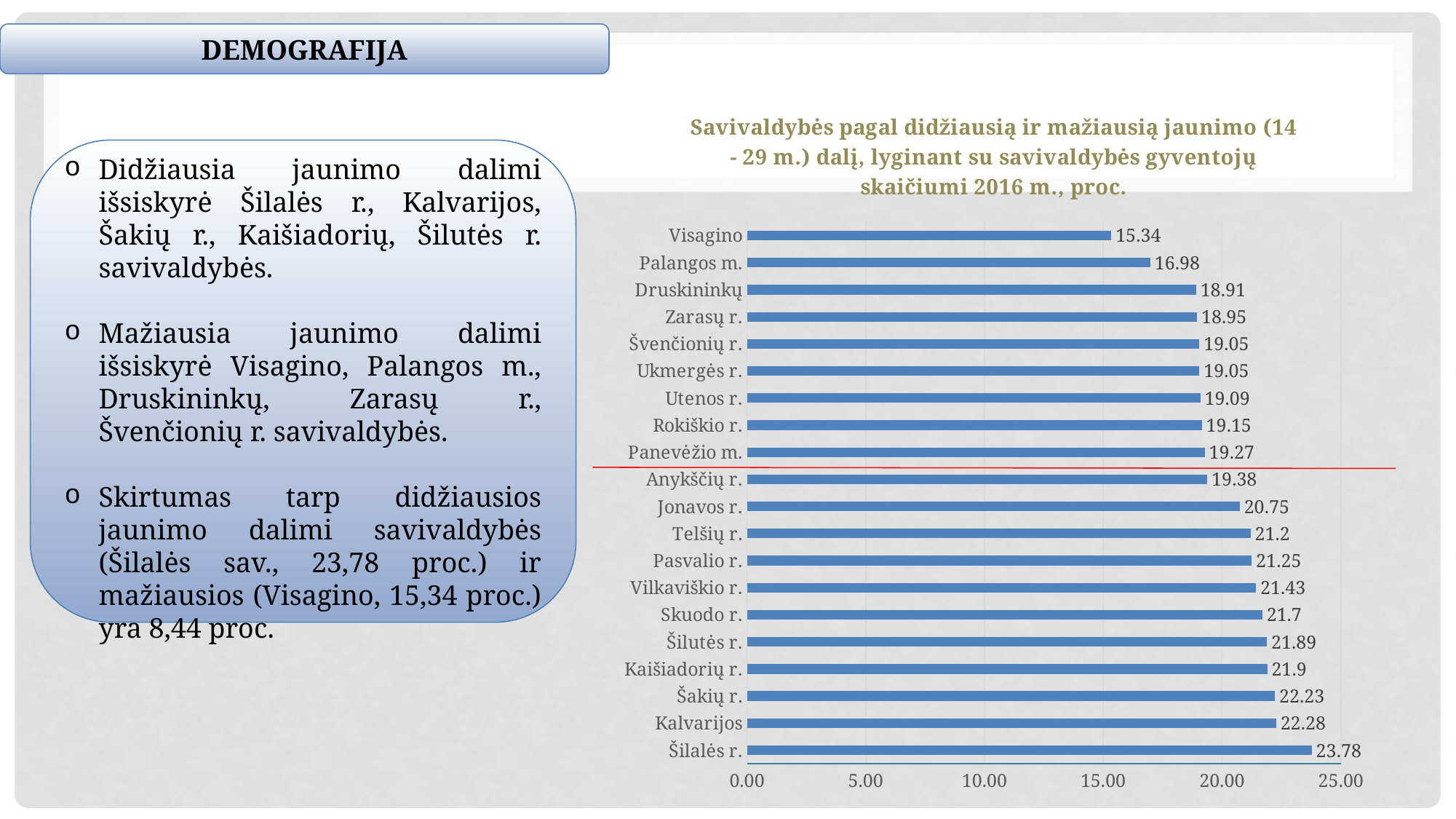
What is the value for Kalvarijos? 22.28 What is the difference between the values for Palangos m. and Druskininkų? 1.93 Which municipality has the highest value? Šilalės r. Is the value for Šakių r. greater or less than 20.00? greater How many municipalities are shown in the chart? 20 Which is larger, the value for Skuodo r. or the value for Telšių r.? Skuodo r. What is the value for Visagino? 15.34 What is the value for Jonavos r.? 20.75 Which municipality has the lowest value? Visagino What kind of chart is shown on the slide? Bar chart Do the values increase or decrease going from the top bar (Visagino) to the bottom bar (Šilalės r.)? Increase What is the difference between the values for Šilalės r. and Visagino? 8.44